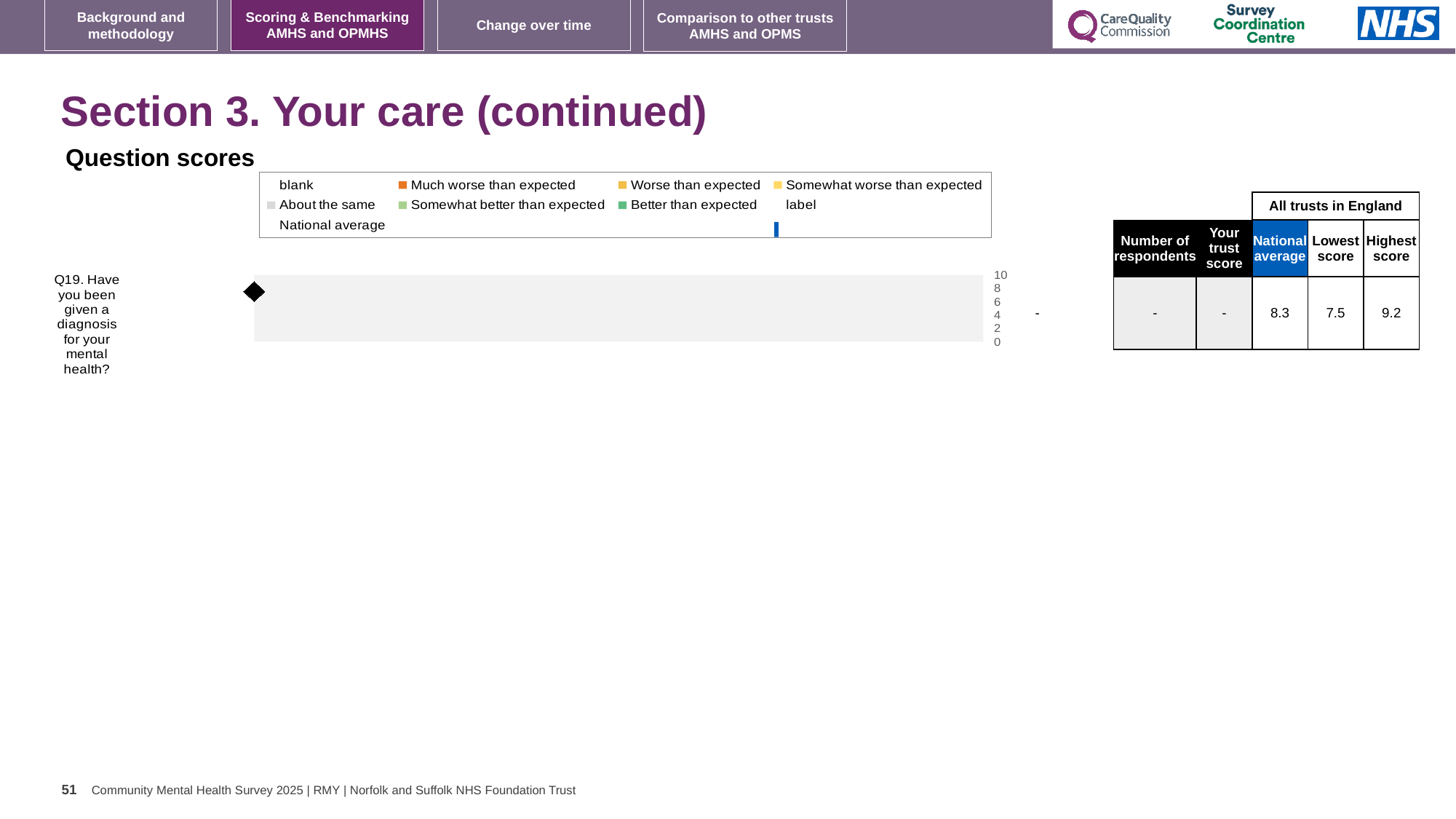
Is the national average for Q19 greater or less than 8? greater Which question is plotted in the Question scores chart? Q19. Have you been given a diagnosis for your mental health? Which is larger for Q19: the national average or the lowest score? national average How many questions (categories) are plotted in the Question scores chart? 1 What is the difference between the highest score and the lowest score for Q19 in the table? 1.7 In the table next to the chart, what is the lowest score among all trusts in England for Q19? 7.5 What is the highest value shown on the chart's axis? 10 In the table next to the chart, what is the highest score among all trusts in England for Q19? 9.2 In the table next to the chart, what is shown as the trust's own score for Q19? - In the table next to the chart, what is the national average score for Q19? 8.3 What kind of chart is shown under 'Question scores'? bar chart